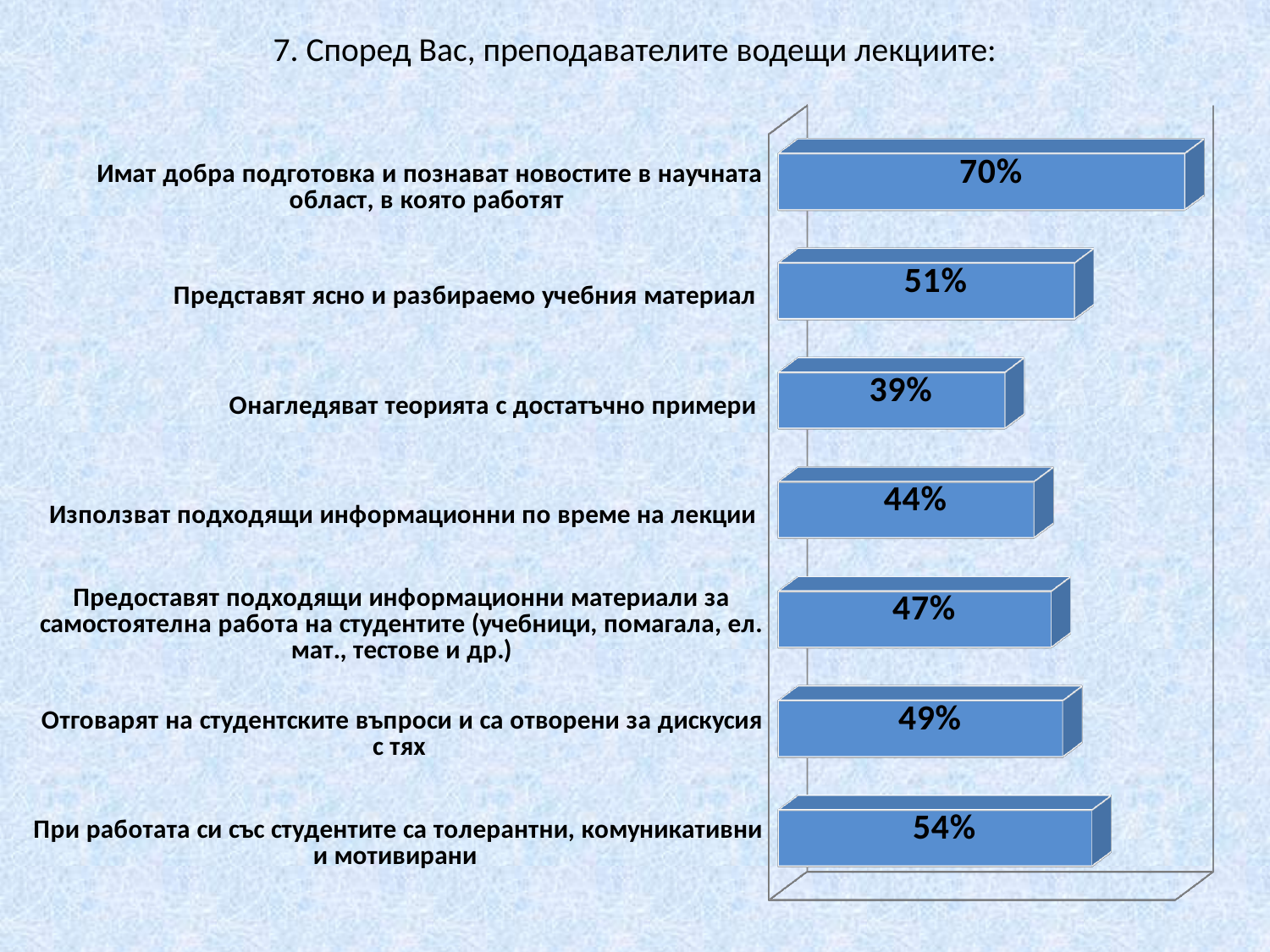
What is the value for "Онагледяват теорията с достатъчно примери"? 39% What is the title of the slide? 7. Според Вас, преподавателите водещи лекциите: What is the difference between the values for "Предоставят подходящи информационни материали за самостоятелна работа на студентите (учебници, помагала, ел. мат., тестове и др.)" and "Използват подходящи информационни по време на лекции"? 3% What is the value for "Отговарят на студентските въпроси и са отворени за дискусия с тях"? 49% What kind of chart is shown on the slide? Bar chart What is the difference between the values for "Имат добра подготовка и познават новостите в научната област, в която работят" and "Представят ясно и разбираемо учебния материал"? 19% How many categories are shown in the chart? 7 What is the value for "При работата си със студентите са толерантни, комуникативни и мотивирани"? 54% Which category has the highest value? Имат добра подготовка и познават новостите в научната област, в която работят What is the value for "Имат добра подготовка и познават новостите в научната област, в която работят"? 70% Which is larger: the value for "Представят ясно и разбираемо учебния материал" or the value for "При работата си със студентите са толерантни, комуникативни и мотивирани"? При работата си със студентите са толерантни, комуникативни и мотивирани Which category has the lowest value? Онагледяват теорията с достатъчно примери